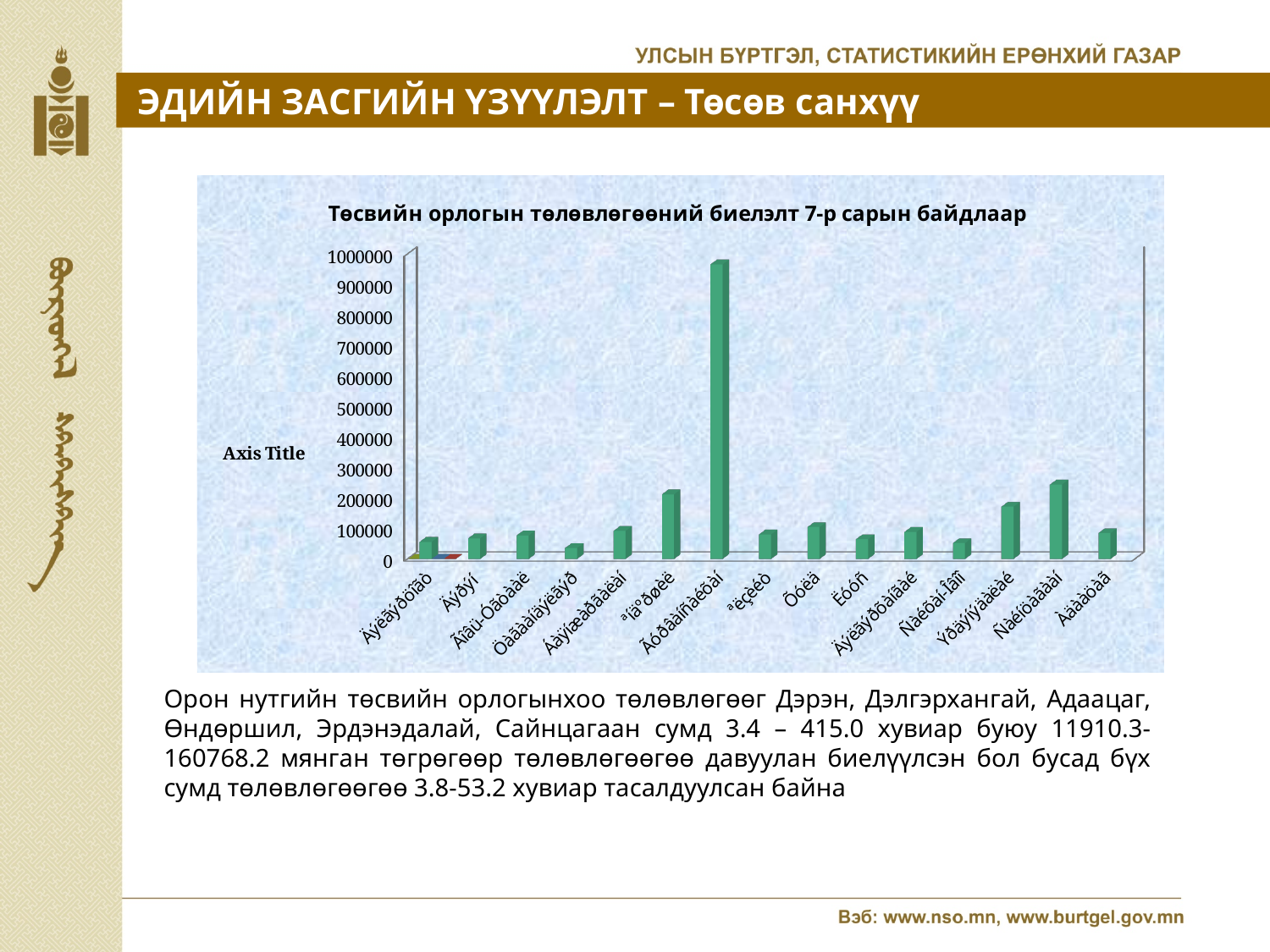
What is the title of the chart? Төсвийн орлогын төлөвлөгөөний биелэлт 7-р сарын байдлаар Is the value of the first bar on the left greater or less than 100000? less Is the value of the tallest bar in the chart greater or less than 1000000? less Which is larger: the value of the seventh bar from the left or the value of the sixth bar from the left? the seventh bar What kind of chart is shown on the slide? bar chart What is the highest tick value shown on the vertical axis of the chart? 1000000 Is the value of the tallest bar in the chart greater or less than 900000? greater Counting from the left, which bar is the tallest in the chart? the seventh bar How many bars in the chart exceed 500000? 1 How many bars (categories) are plotted in the chart? 15